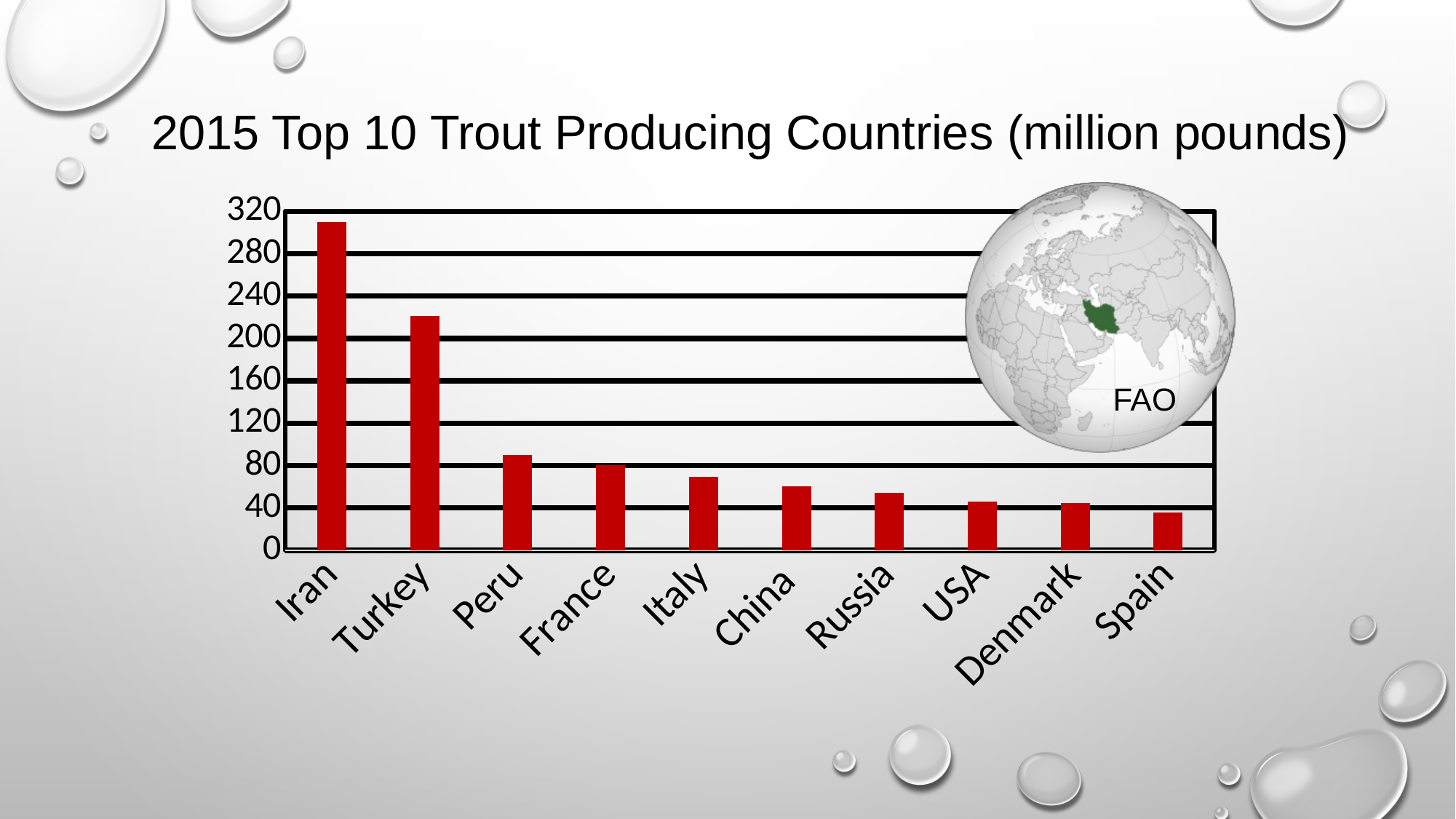
Is the value for Russia greater or less than 40? greater What is the title of the chart? 2015 Top 10 Trout Producing Countries (million pounds) Is the value for Turkey greater or less than 200? greater Which has the larger value, Turkey or Peru? Turkey How many countries are shown on the chart? 10 Is the value for Peru greater or less than 120? less Do the values rise or fall moving from left to right along the x axis? fall Which country has the lowest trout production on the chart? Spain What kind of chart is shown on the slide? bar chart Which country has the highest trout production on the chart? Iran